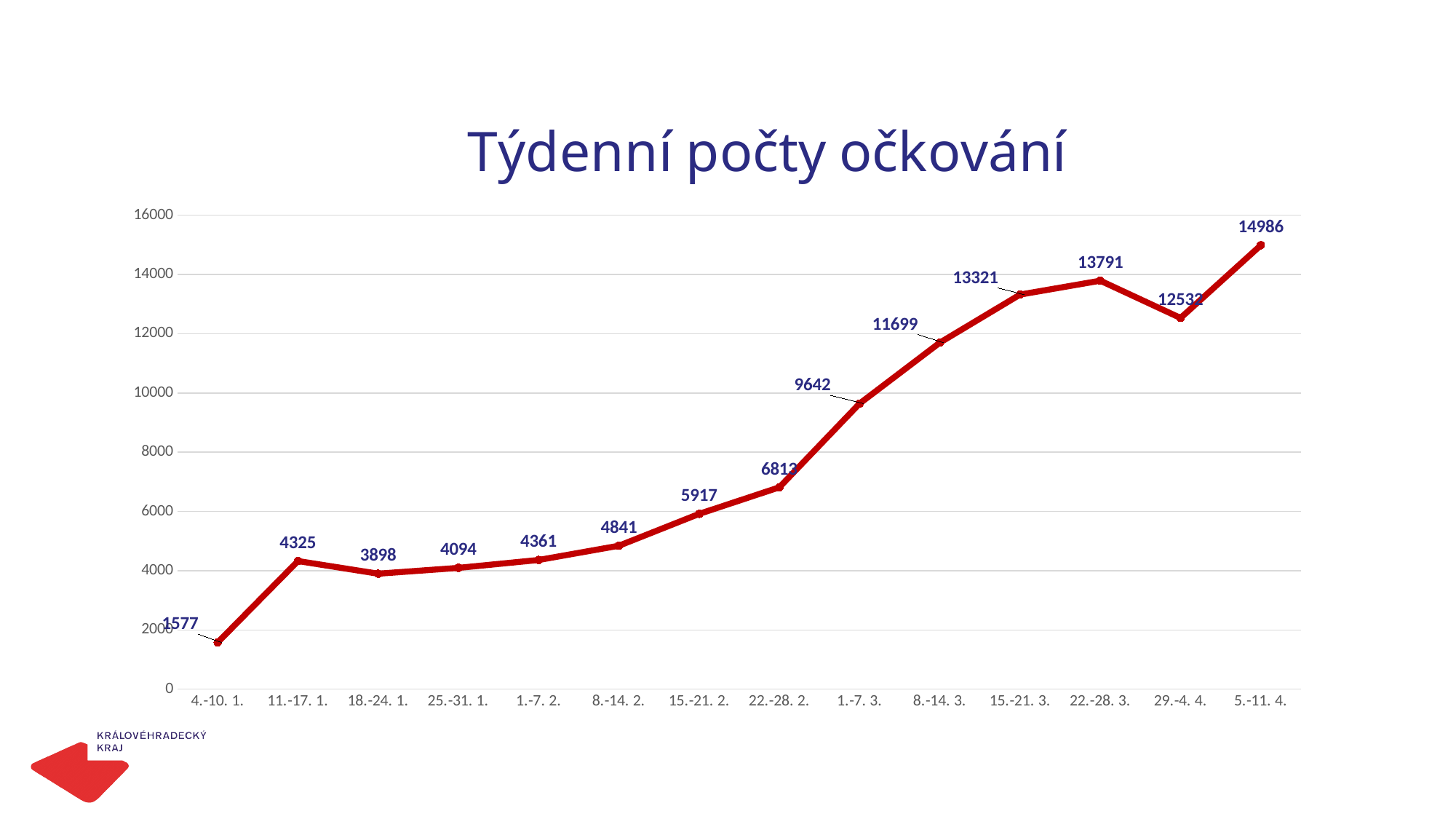
What is the value for the week 5.-11. 4.? 14986 Which week has the highest value? 5.-11. 4. What kind of chart is shown on the slide? line chart Which week has the lowest value? 4.-10. 1. What is the difference between the values for 5.-11. 4. and 22.-28. 3.? 1195 Which is larger, the value for 11.-17. 1. or for 18.-24. 1.? 11.-17. 1. Do the values generally rise or fall from the first week to the last week? rise How many weeks are plotted on the chart? 14 What is the value for the week 1.-7. 3.? 9642 What is the value for the week 4.-10. 1.? 1577 What is the difference between the values for 15.-21. 3. and 8.-14. 3.? 1622 Is the value for 29.-4. 4. greater or less than 12000? greater